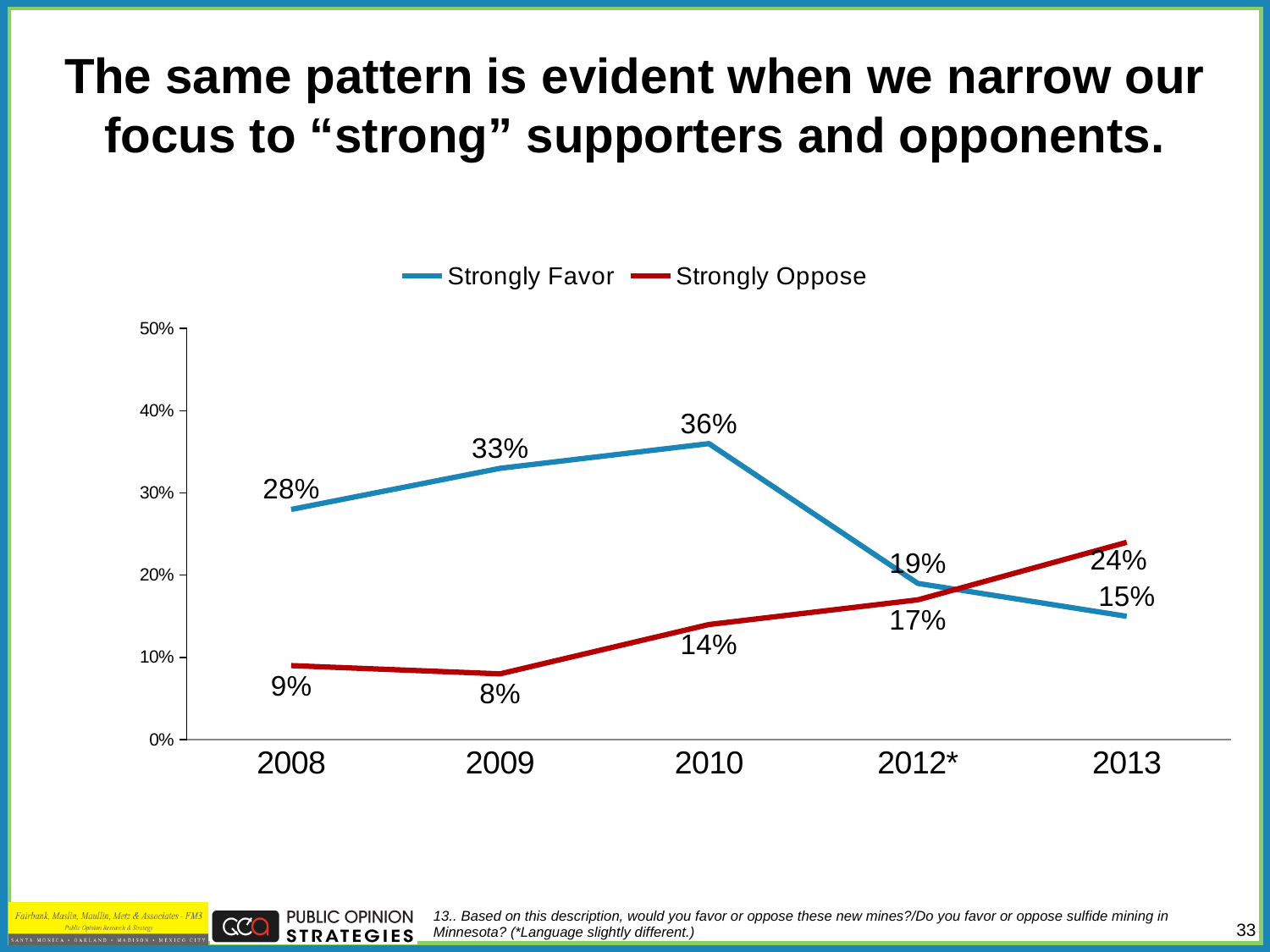
Is the Strongly Favor value in 2009 greater or less than 30%? greater How many years are shown on the x axis? 5 In which year is Strongly Favor highest? 2010 What kind of chart is shown? line chart What is the difference between Strongly Favor and Strongly Oppose in 2008? 19% What is the Strongly Oppose value in 2009? 8% What is the Strongly Favor value in 2010? 36% In which year is Strongly Oppose lowest? 2009 What is the Strongly Favor value in 2013? 15% Which is larger in 2013, Strongly Favor or Strongly Oppose? Strongly Oppose Does the Strongly Oppose line rise or fall from 2009 to 2013? rise How many series does the legend list? 2